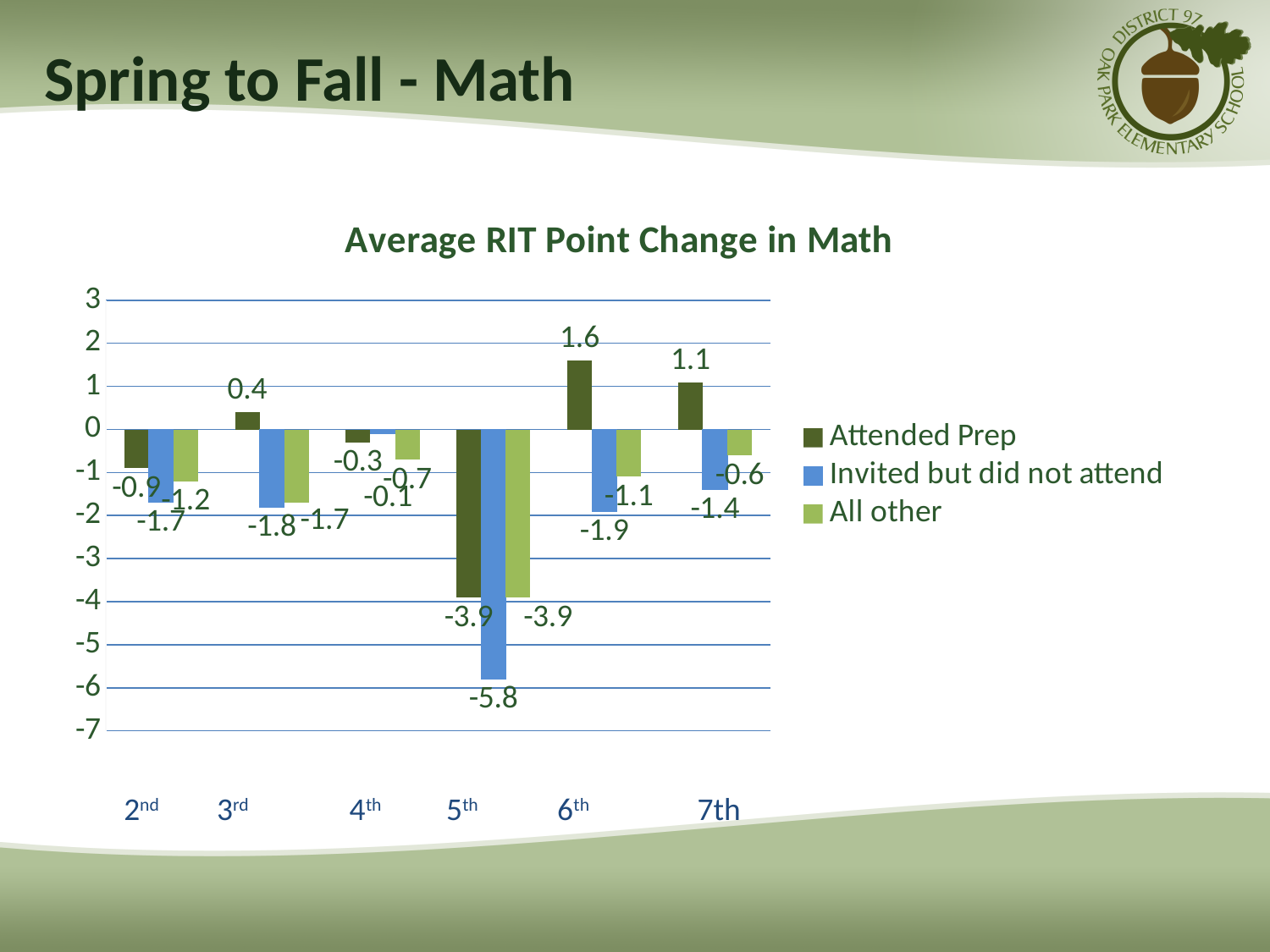
How many series does the legend list? 3 What is the value for Attended Prep in 3rd grade? 0.4 What is the title of the chart? Average RIT Point Change in Math What kind of chart is shown? Bar chart How many grade categories are shown on the x axis? 6 Which grade has the highest value for Attended Prep? 6th What is the value for Invited but did not attend in 5th grade? -5.8 Which grade has the lowest value for Invited but did not attend? 5th What is the difference between the Attended Prep value and the Invited but did not attend value in 6th grade? 3.5 What is the value for Attended Prep in 6th grade? 1.6 In 7th grade, which is larger: the Attended Prep value or the All other value? Attended Prep What is the value for All other in 7th grade? -0.6